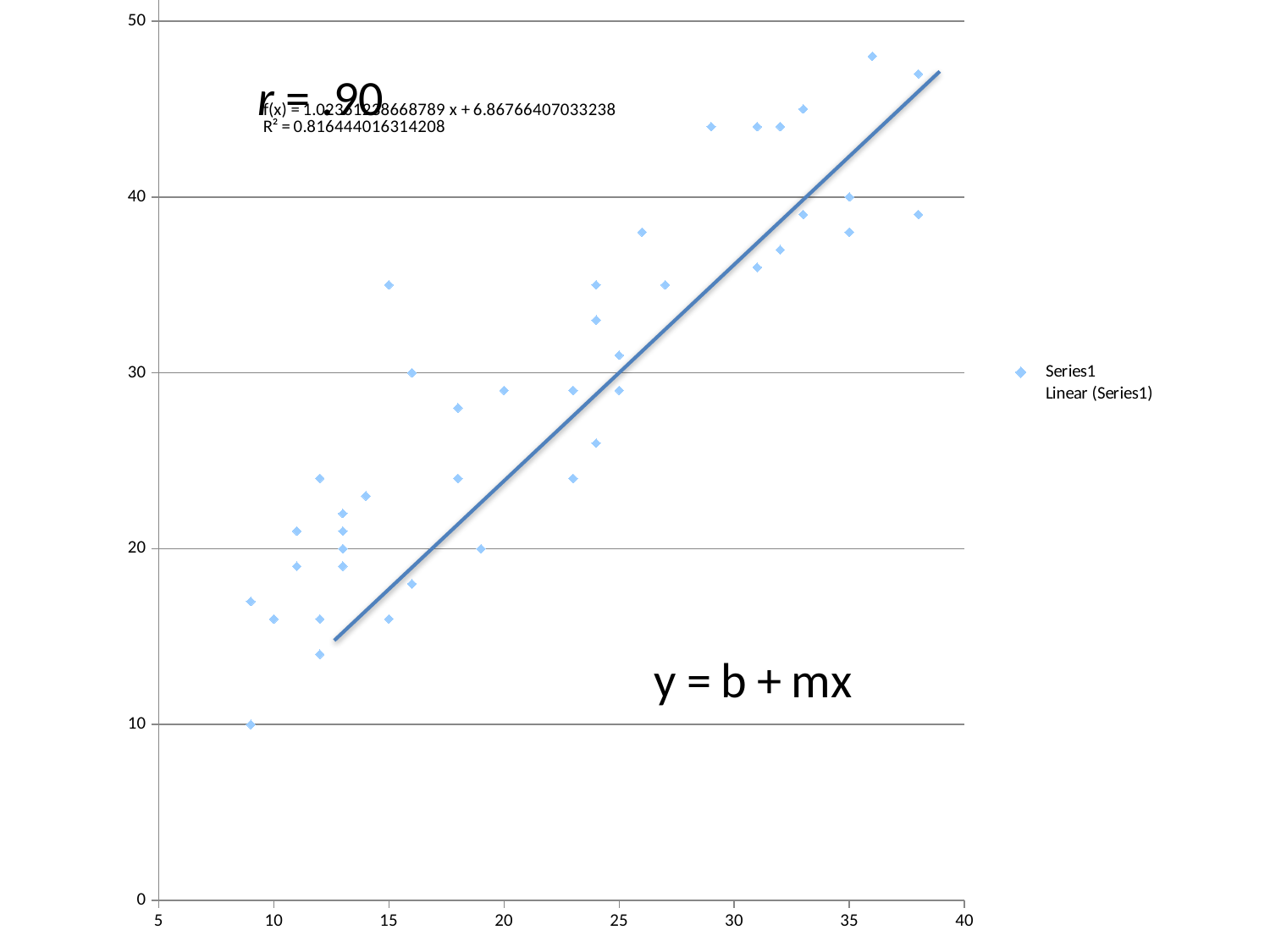
Is the y value of the lowest plotted point greater or less than 20? less What are the two entries listed in the legend? Series1 and Linear (Series1) What is the maximum value shown on the y axis? 50 How many entries does the legend list? 2 Is the y value of the trendline at x = 35 greater or less than 30? greater What R² value is printed on the chart? 0.816444016314208 What kind of chart is shown on the slide? scatter chart Do the plotted values generally rise or fall as the x value increases? rise Is the y value of the highest plotted point greater or less than 40? greater